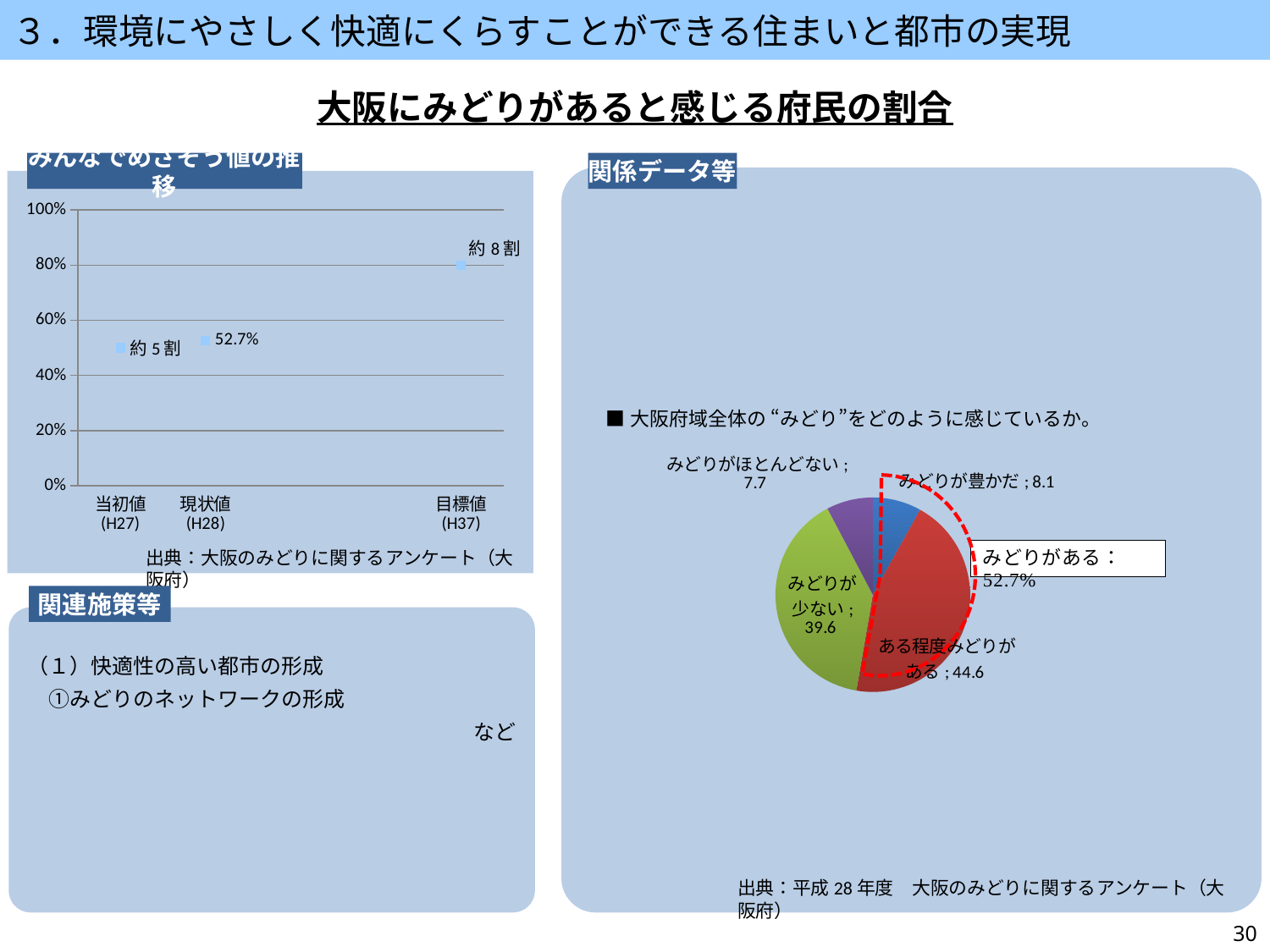
In the pie chart on the right, what is the combined share labelled みどりがある (みどりが豊かだ plus ある程度みどりがある)? 52.7% In the left chart (みんなでめざそう値の推移), do the values rise or fall from 当初値 (H27) to 目標値 (H37)? rise In the left chart (みんなでめざそう値の推移), what label is shown for the 目標値 (H37) point? 約8割 In the pie chart on the right, what is the value for ある程度みどりがある? 44.6 In the pie chart on the right, what is the value for みどりが少ない? 39.6 In the left chart (みんなでめざそう値の推移), how many data points are plotted? 3 In the left chart (みんなでめざそう値の推移), what is the value shown for 現状値 (H28)? 52.7% In the left chart (みんなでめざそう値の推移), is the value for 目標値 (H37) greater or less than 60%? greater In the pie chart on the right, what is the difference between ある程度みどりがある and みどりが少ない? 5.0 In the pie chart on the right, which category has the largest slice? ある程度みどりがある In the pie chart on the right, which category has the smallest slice? みどりがほとんどない In the left chart (みんなでめざそう値の推移), what label is shown for the 当初値 (H27) point? 約5割